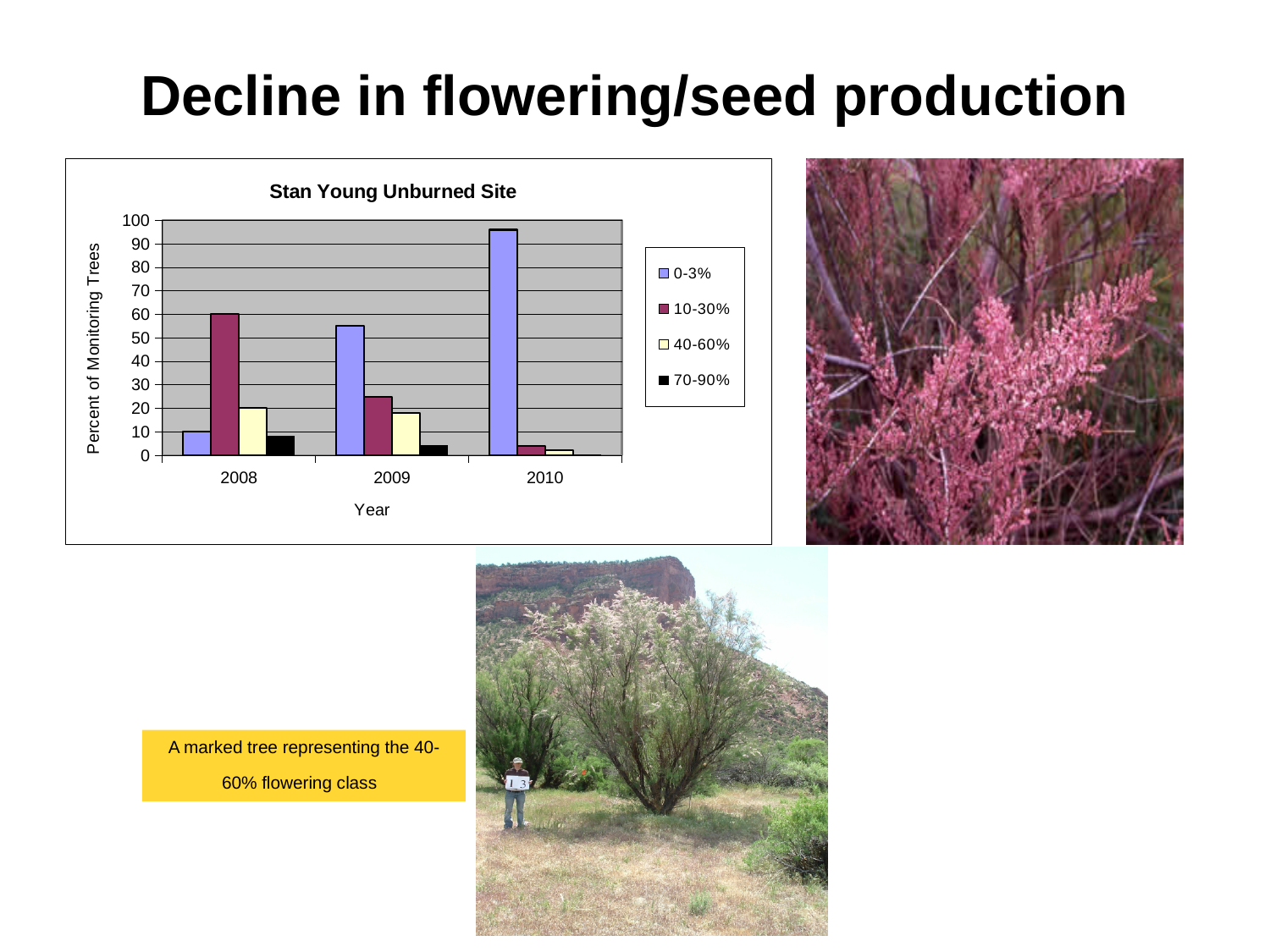
Does the 10-30% series rise or fall from 2008 to 2010? fall Does the 0-3% series rise or fall from 2008 to 2010? rise In which year is the 0-3% bar the lowest? 2008 In which year is the 0-3% bar the highest? 2010 Is the value for 0-3% in 2009 greater or less than 50? greater How many series does the legend of the Stan Young Unburned Site chart list? 4 What is the title of the chart? Stan Young Unburned Site What kind of chart is shown on the slide? bar chart What is the label of the y axis of the chart? Percent of Monitoring Trees In 2008, which is larger: the 0-3% bar or the 10-30% bar? 10-30% Is the value for 0-3% in 2010 greater or less than 90? greater How many years are shown on the x axis of the Stan Young Unburned Site chart? 3